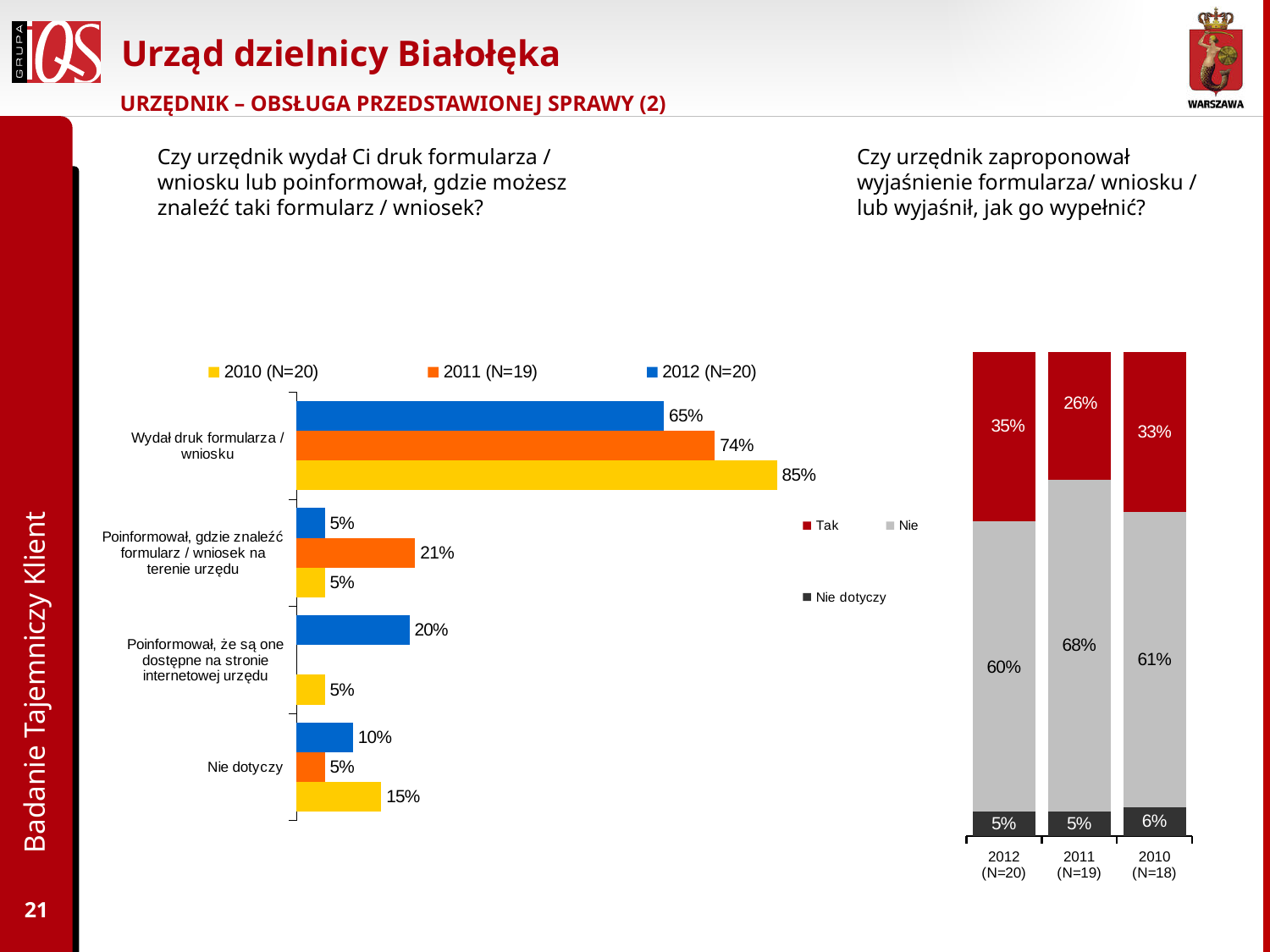
What kind of chart is the left chart? Bar chart In the right stacked chart, what is the 'Tak' value for 2011 (N=19)? 26% In the right stacked chart, what is the 'Nie' value for 2010 (N=18)? 61% In the right stacked chart, what is the total of the 2012 (N=20) bar? 100% In the left chart, what is the value for 'Wydał druk formularza / wniosku' in 2010 (N=20)? 85% In the left chart, what is the difference between the 2010 and 2012 values for 'Wydał druk formularza / wniosku'? 20 percentage points In the left chart, what is the value for 'Wydał druk formularza / wniosku' in 2011 (N=19)? 74% In the left chart, how many series does the legend list? 3 In the left chart, what is the value for 'Nie dotyczy' in 2012 (N=20)? 10% In the left chart, what is the value for 'Poinformował, gdzie znaleźć formularz / wniosek na terenie urzędu' in 2011 (N=19)? 21% In the left chart, which year has the highest value for 'Wydał druk formularza / wniosku'? 2010 (N=20) In the right stacked chart, which year has the highest 'Nie' value? 2011 (N=19)